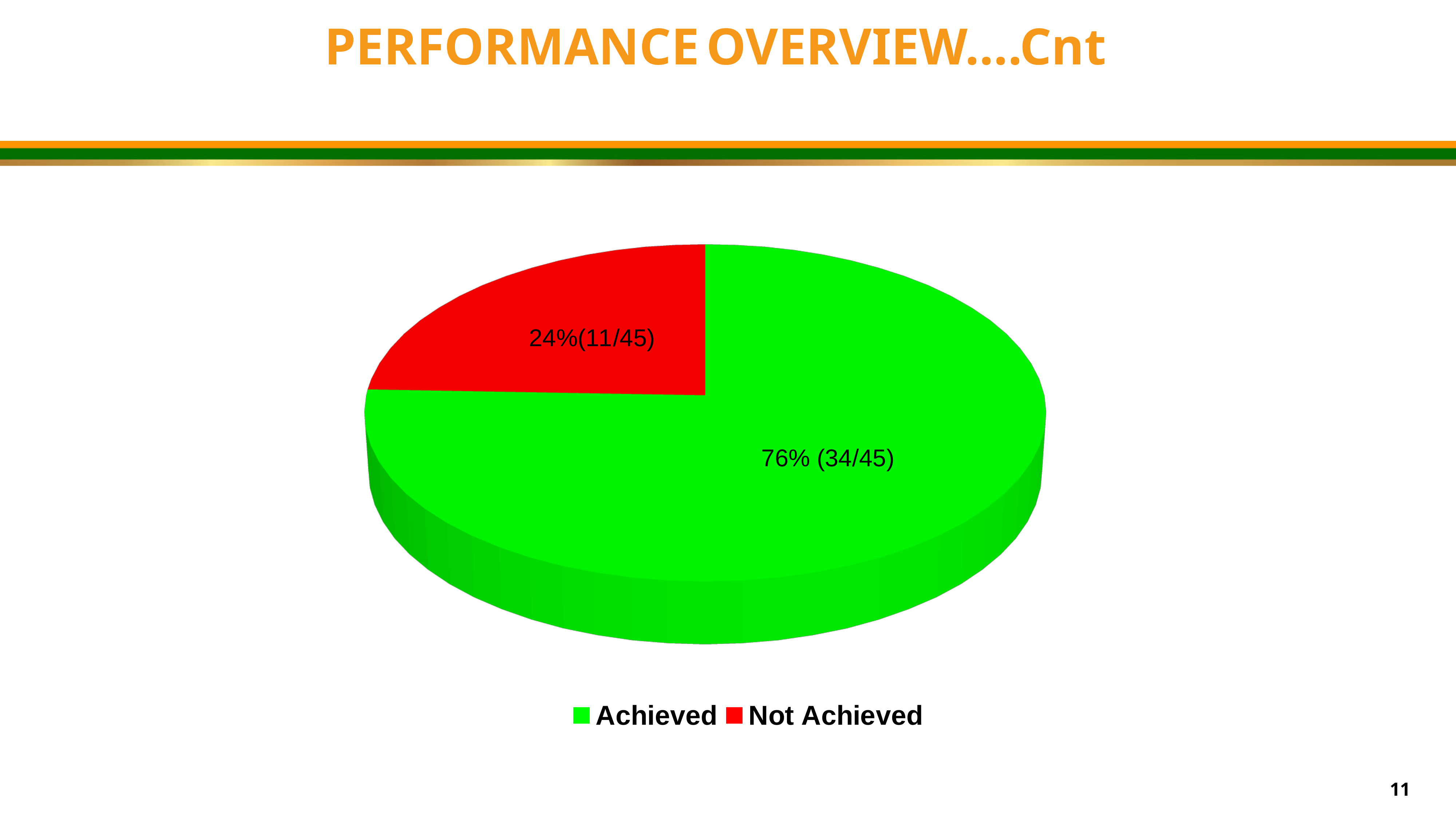
What percentage of the pie is labelled Achieved? 76% Which is larger, the Achieved slice or the Not Achieved slice? Achieved How many slices does the pie chart have? 2 What is the title of the slide containing the pie chart? PERFORMANCE OVERVIEW....Cnt What kind of chart is shown on the slide? pie chart What colour is the Not Achieved slice? red What percentage of the pie is labelled Not Achieved? 24% What fraction is shown in the data label for the Not Achieved slice? 11/45 What fraction is shown in the data label for the Achieved slice? 34/45 Which slice is the smallest in the pie chart? Not Achieved Which slice is the largest in the pie chart? Achieved What is the difference in percentage points between the Achieved and Not Achieved slices? 52